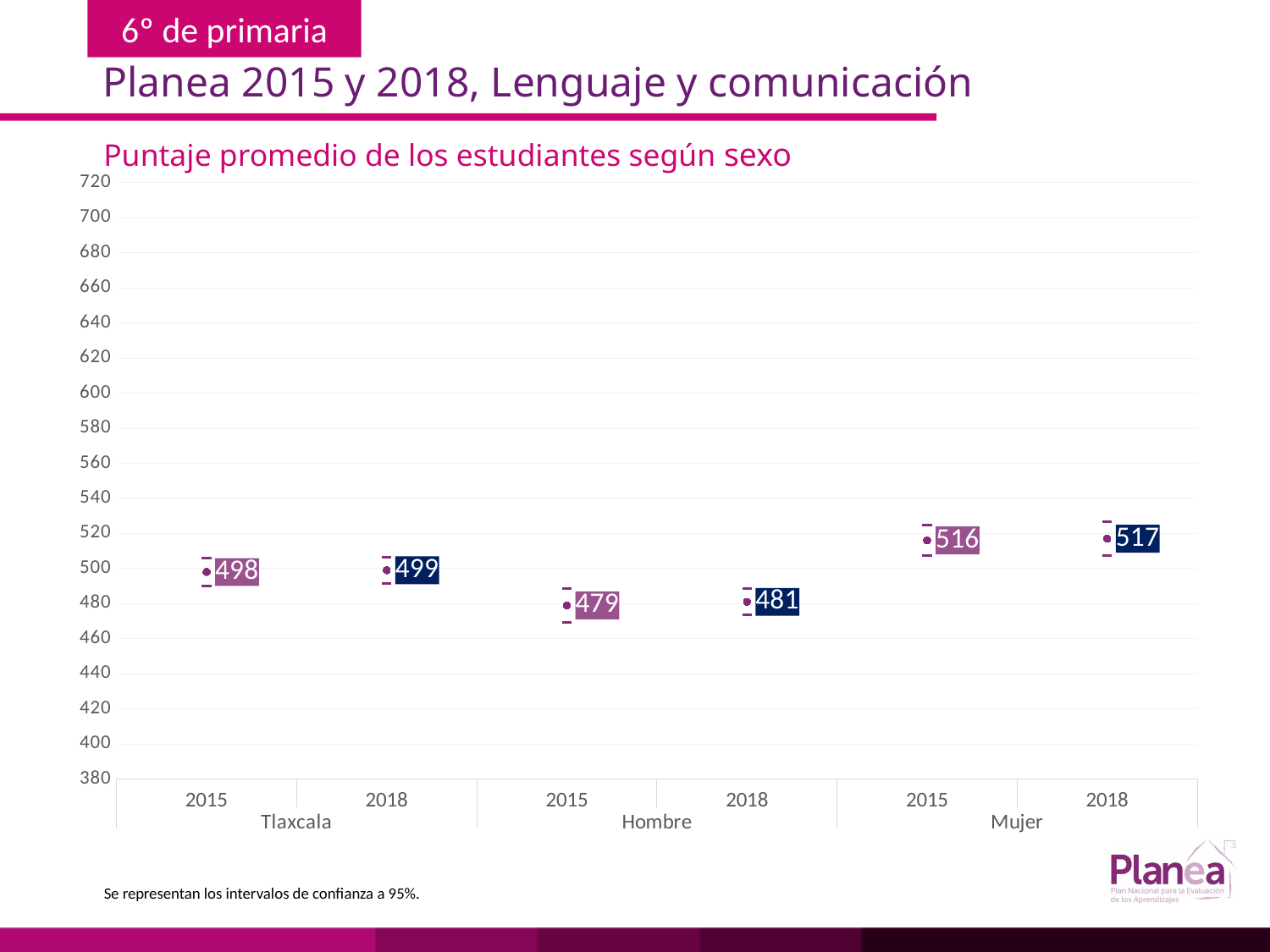
Which group and year has the lowest average score? Hombre 2015 How many data points are plotted on the chart? 6 Did the Hombre average score rise or fall from 2015 to 2018? rise Which group and year has the highest average score? Mujer 2018 What is the average score for Hombre in 2018? 481 What is the title of the chart? Puntaje promedio de los estudiantes según sexo By how much did the Tlaxcala average score change from 2015 to 2018? 1 Which is larger, the Hombre 2015 score or the Tlaxcala 2015 score? Tlaxcala 2015 What is the average score for Mujer in 2018? 517 What is the average score for Mujer in 2015? 516 What is the average score for Tlaxcala in 2015? 498 What is the difference between the Mujer 2018 score and the Hombre 2018 score? 36